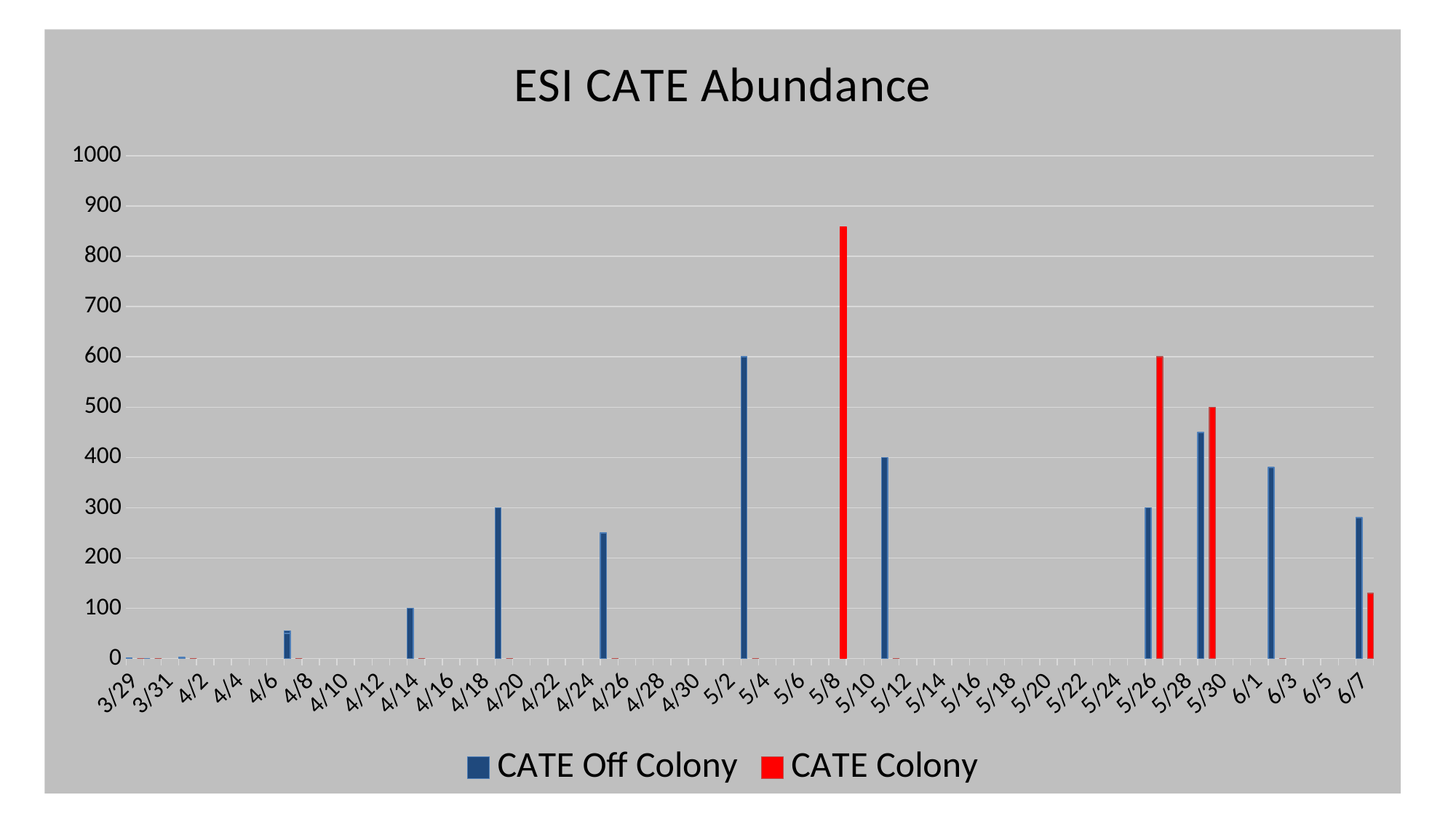
What is the title of the chart? ESI CATE Abundance What is the CATE Off Colony value on 5/2? 600 Is the CATE Off Colony value on 4/24 greater or less than 300? less On which date is the CATE Off Colony value highest? 5/2 What is the CATE Colony value on 5/26? 600 How many series does the legend list? 2 On 6/7, which series has the larger value, CATE Off Colony or CATE Colony? CATE Off Colony Which series is shown in red? CATE Colony What type of chart is shown on the slide? bar chart On which date is the CATE Colony value highest? 5/8 Is the CATE Colony value on 5/8 greater or less than 800? greater How many dates are labelled along the x axis? 36